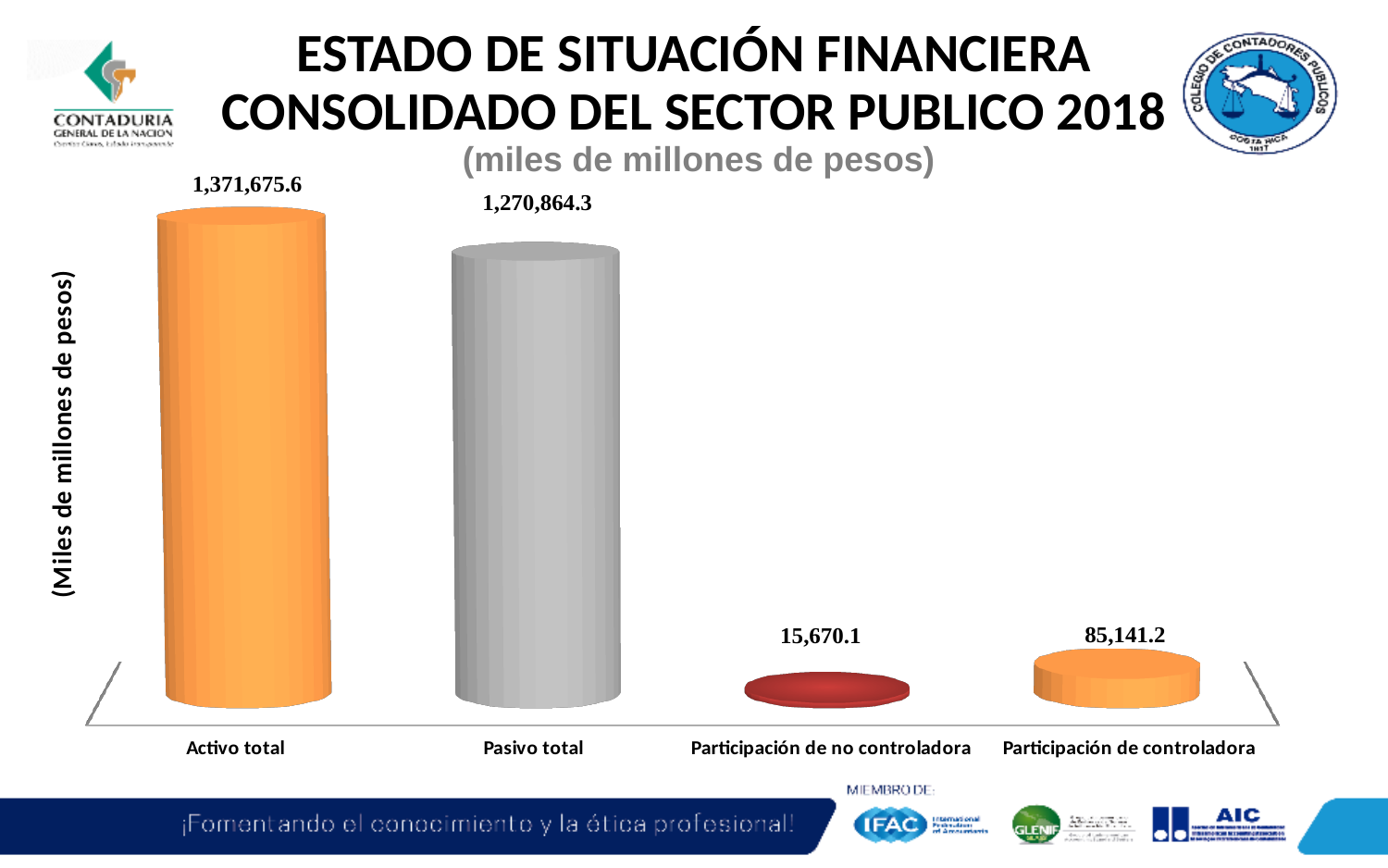
How many categories are shown in the chart? 4 What is the difference between Activo total and Pasivo total? 100,811.3 What is the difference between Participación de controladora and Participación de no controladora? 69,471.1 What is the value for Activo total? 1,371,675.6 What kind of chart is shown on the slide? Bar chart What is the value for Pasivo total? 1,270,864.3 What is the value for Participación de controladora? 85,141.2 Which category has the highest value? Activo total What unit is given on the vertical axis label of the chart? Miles de millones de pesos Which category has the lowest value? Participación de no controladora Which is larger, Participación de controladora or Participación de no controladora? Participación de controladora What is the value for Participación de no controladora? 15,670.1